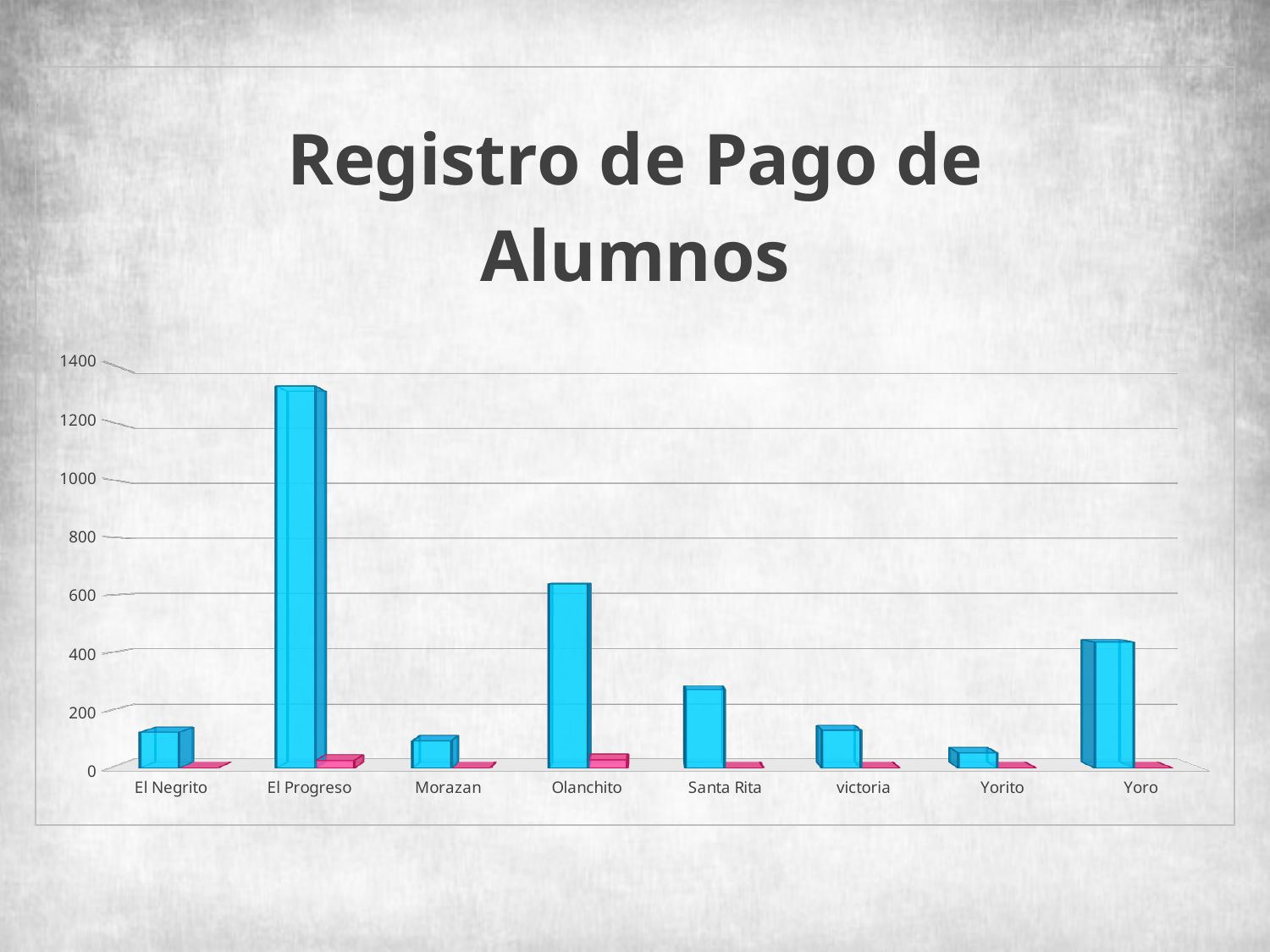
Is the blue bar for Olanchito greater or less than 800? less Which colour of bars is taller in every category, blue or pink? Blue How many categories are shown on the x axis of the chart? 8 Which category has the shortest blue bar? Yorito Is the blue bar for Yoro greater or less than 400? greater Which has the taller blue bar, Santa Rita or Morazan? Santa Rita Is the blue bar for Santa Rita greater or less than 400? less Which has the taller blue bar, Olanchito or Yoro? Olanchito Which category has the tallest blue bar? El Progreso What kind of chart is shown on the slide? Bar chart What is the title of the chart? Registro de Pago de Alumnos